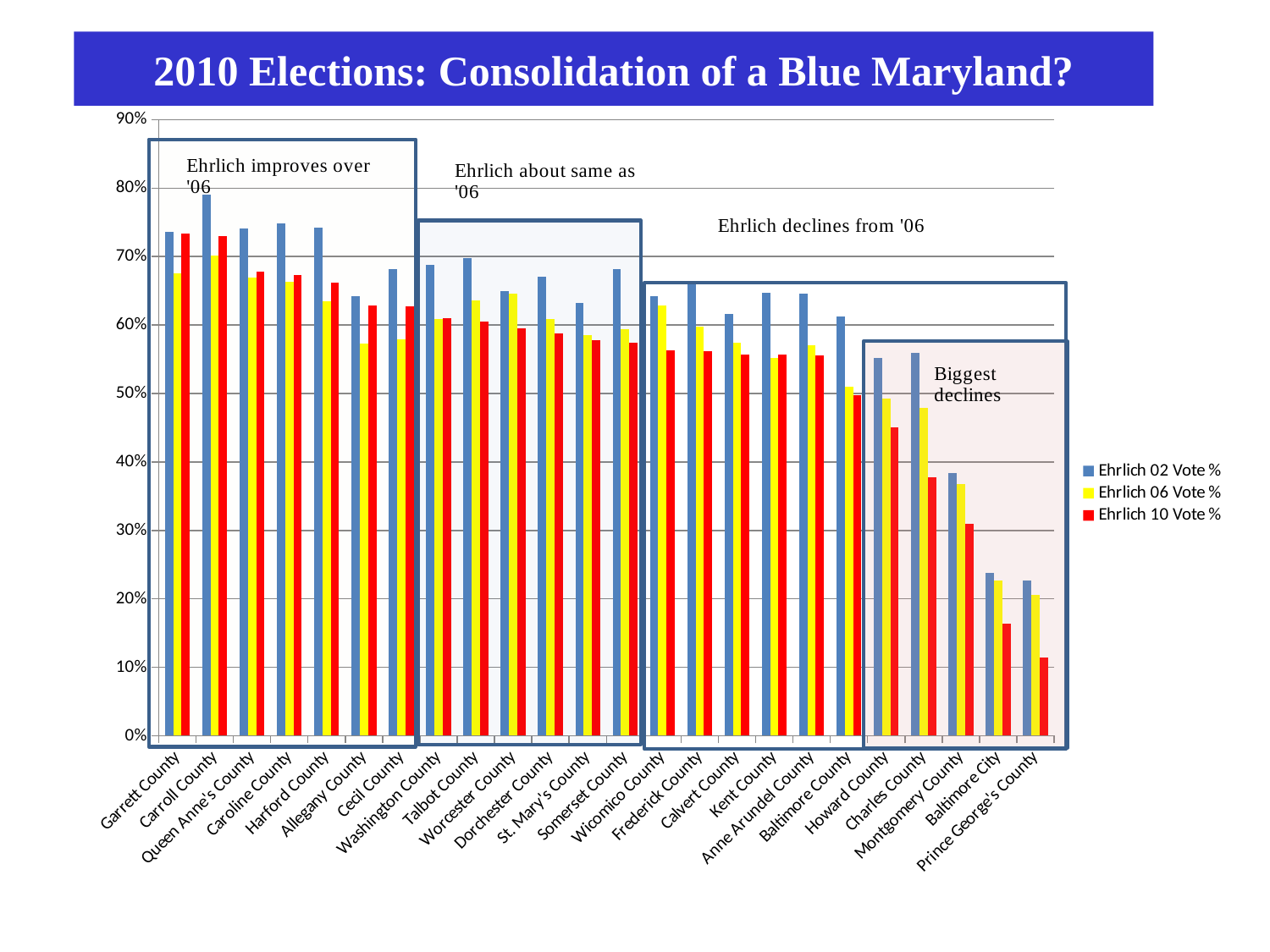
Do the Ehrlich 02 Vote % values generally rise or fall moving from left to right along the x axis? Fall Is the Ehrlich 10 Vote % for Prince George's County greater or less than 20%? less Which series is shown in red in the legend? Ehrlich 10 Vote % What kind of chart is shown on the slide? Bar chart Is the Ehrlich 10 Vote % for Montgomery County greater or less than 40%? less How many series does the legend list? 3 Is the Ehrlich 06 Vote % for Garrett County greater or less than 60%? greater Which county has the lowest Ehrlich 10 Vote %? Prince George's County Which county has the highest Ehrlich 02 Vote %? Carroll County Which is larger for Charles County: the Ehrlich 02 Vote % or the Ehrlich 10 Vote %? Ehrlich 02 Vote % How many counties (categories) are shown on the x axis? 24